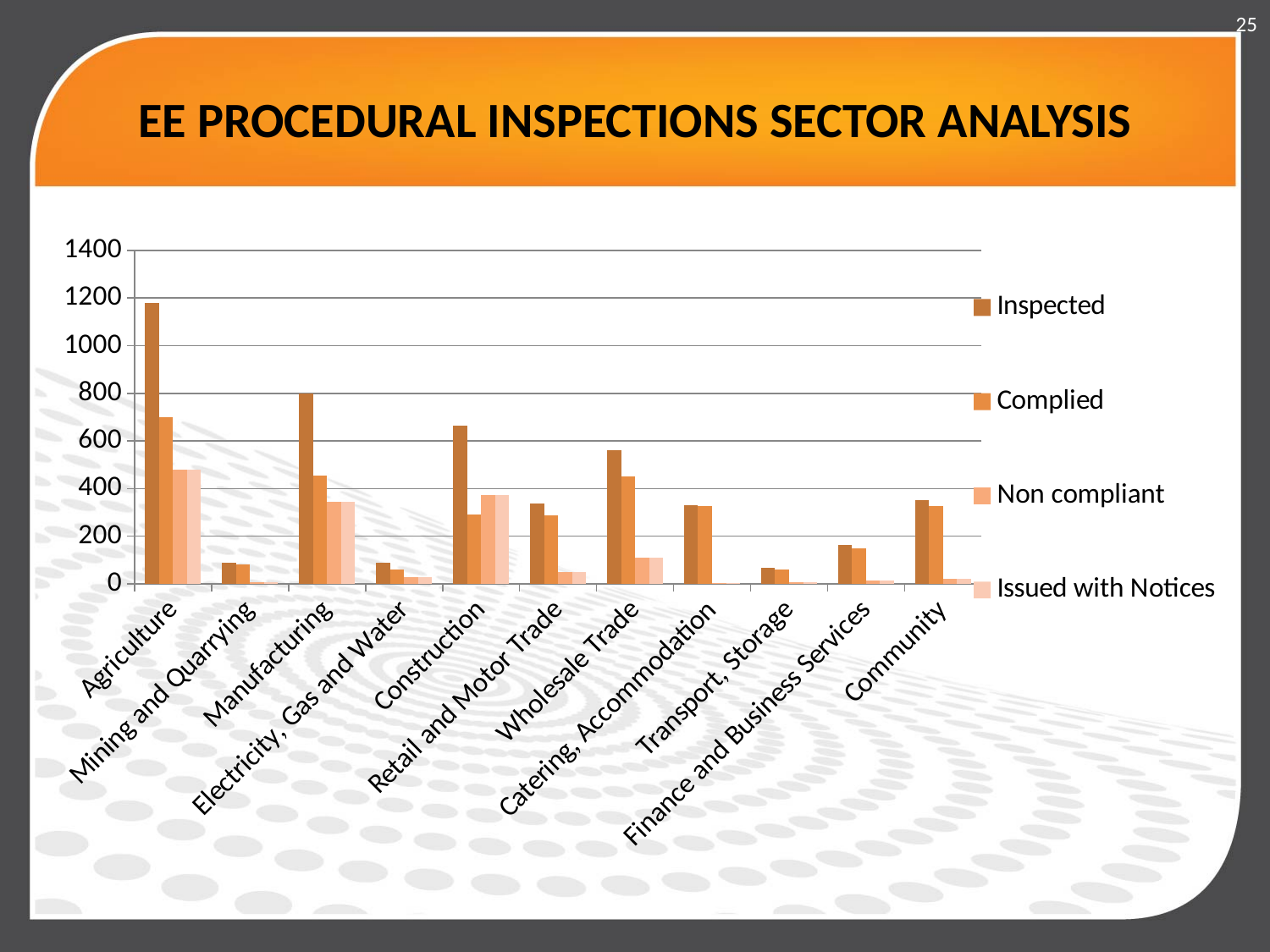
Is the Complied value for Agriculture greater or less than 600? greater Which sector has the highest Inspected value? Agriculture Which is larger, the Inspected value for Construction or the Inspected value for Wholesale Trade? Construction Which is larger, the Inspected value for Manufacturing or the Inspected value for Agriculture? Agriculture What kind of chart is shown on the slide? Bar chart Is the Inspected value for Agriculture greater or less than 1000? greater How many series does the legend list? 4 What is the title of the slide containing the chart? EE PROCEDURAL INSPECTIONS SECTOR ANALYSIS Is the Inspected value for Manufacturing greater or less than 600? greater How many sectors (categories) are shown on the x axis? 11